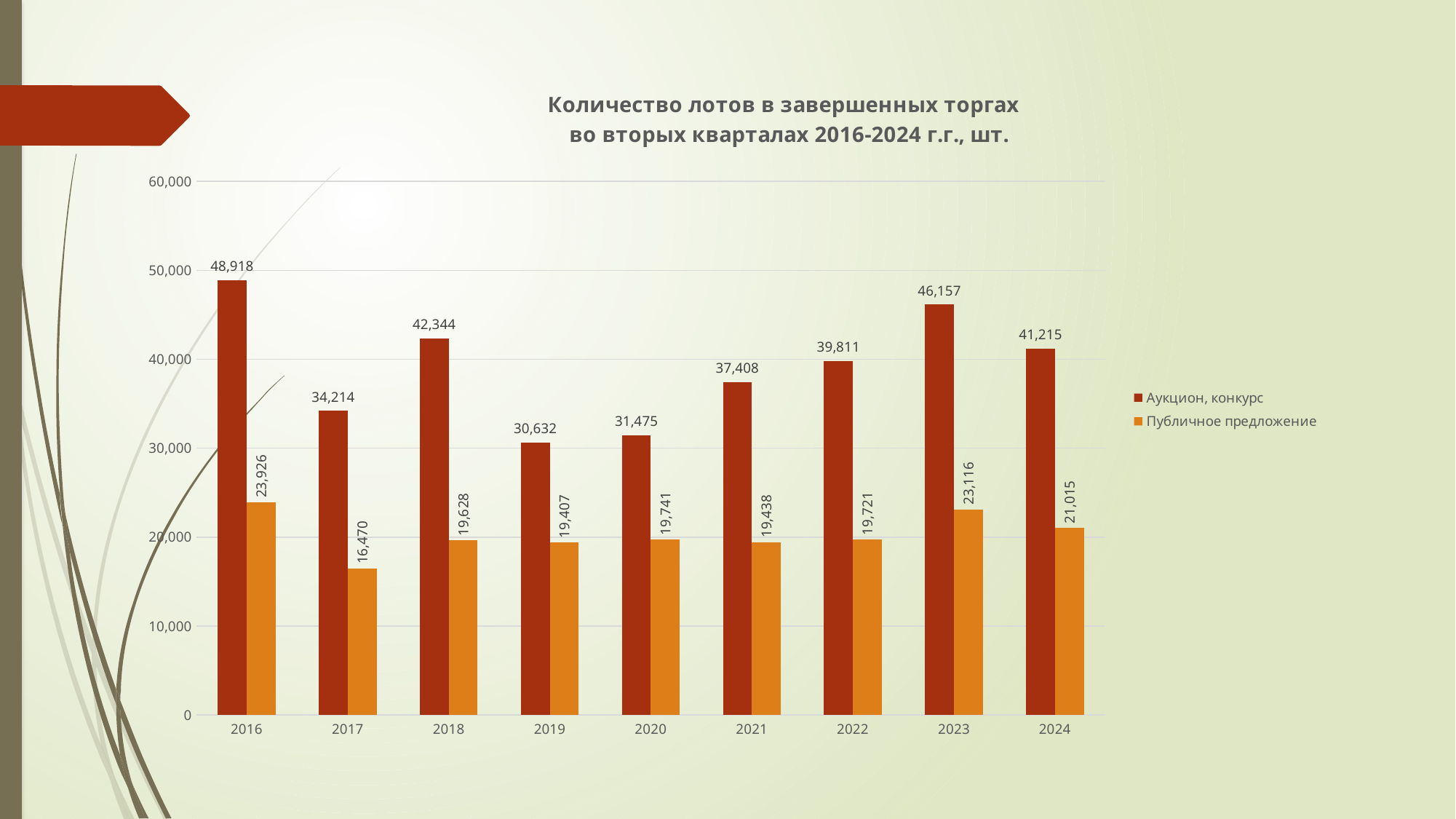
Which series is shown in orange in the legend? Публичное предложение What is the value for Аукцион, конкурс in 2016? 48,918 How many years are shown on the x axis? 9 Which year has the highest value for Аукцион, конкурс? 2016 What kind of chart is shown on the slide? Bar chart How many series does the legend list? 2 What is the value for Публичное предложение in 2024? 21,015 What is the value for Публичное предложение in 2017? 16,470 What is the difference between Аукцион, конкурс and Публичное предложение in 2024? 20,200 What is the value for Аукцион, конкурс in 2023? 46,157 Which is larger: Аукцион, конкурс in 2018 or Аукцион, конкурс in 2022? Аукцион, конкурс in 2018 Which year has the lowest value for Публичное предложение? 2017